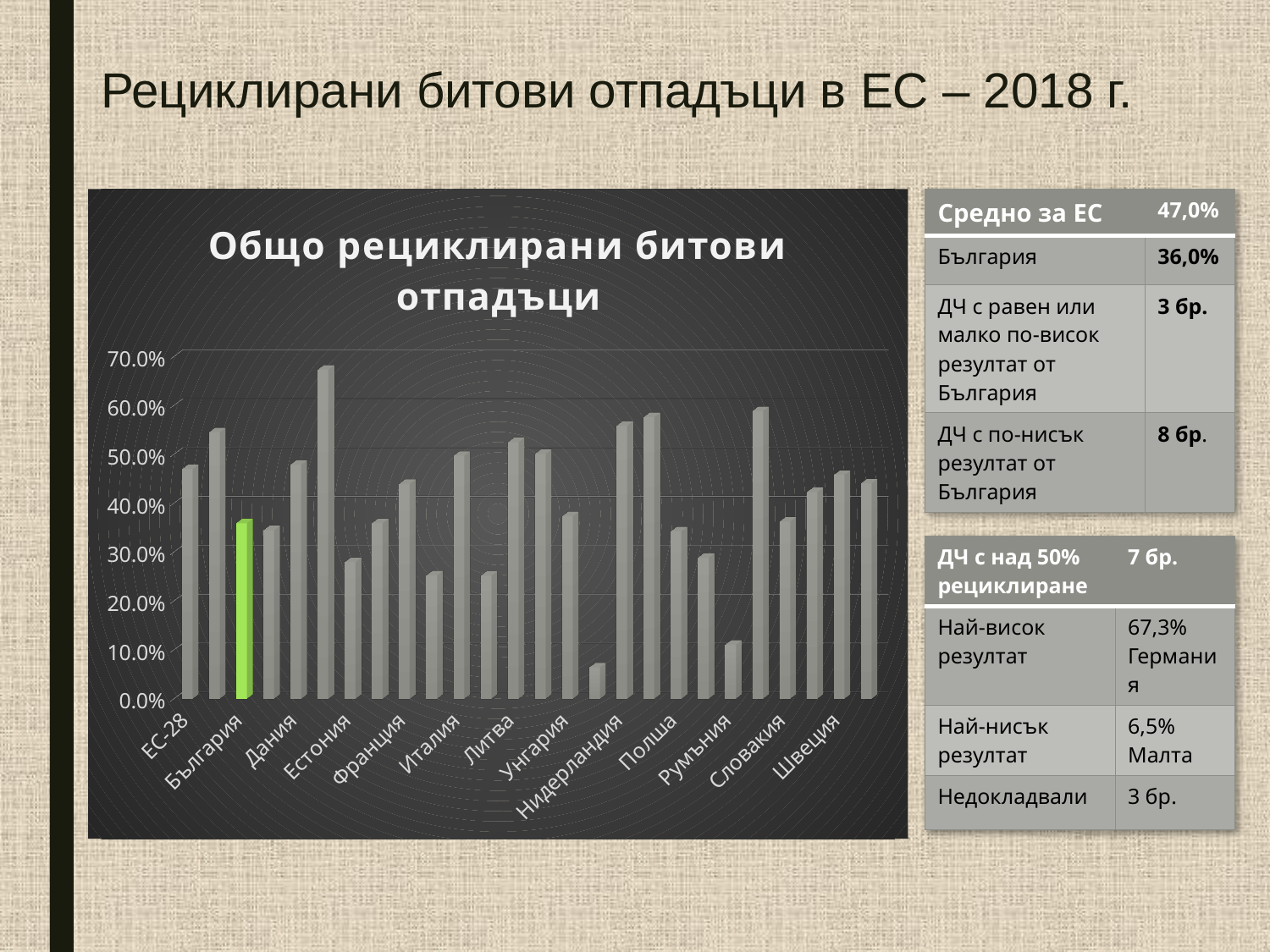
Is the value for Естония greater or less than 30.0%? less Which has the larger value, Нидерландия or Румъния? Нидерландия Is the value for Нидерландия greater or less than 50.0%? greater What is the title of the chart? Общо рециклирани битови отпадъци Is the value for Полша greater or less than 40.0%? less Which category's bar is highlighted in green in the chart? България What kind of chart is shown on the slide? bar chart Which has the larger value, ЕС-28 or България? ЕС-28